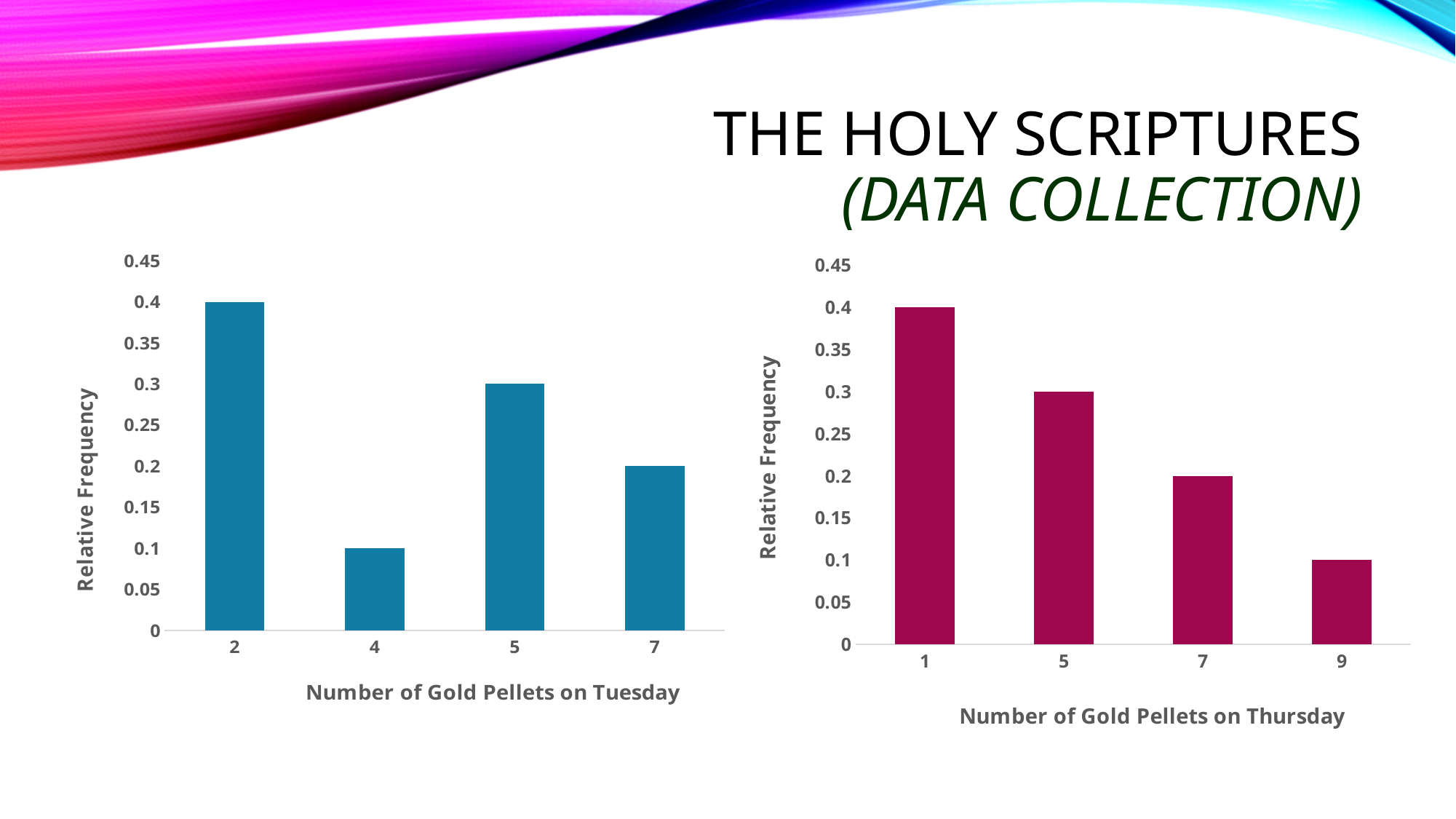
How many categories are shown on the x axis of the chart for Number of Gold Pellets on Thursday (right)? 4 In the chart for Number of Gold Pellets on Tuesday (left), is the relative frequency for 5 gold pellets greater or less than 0.25? greater In the chart for Number of Gold Pellets on Thursday (right), what is the relative frequency for 9 gold pellets? 0.1 In the chart for Number of Gold Pellets on Tuesday (left), which number of gold pellets has the highest relative frequency? 2 In the chart for Number of Gold Pellets on Thursday (right), what is the relative frequency for 5 gold pellets? 0.3 In the chart for Number of Gold Pellets on Thursday (right), do the relative frequencies rise or fall as the number of gold pellets increases along the x axis? fall In the chart for Number of Gold Pellets on Tuesday (left), what is the difference between the relative frequency for 5 gold pellets and for 7 gold pellets? 0.1 In the chart for Number of Gold Pellets on Tuesday (left), what is the relative frequency for 4 gold pellets? 0.1 In the chart for Number of Gold Pellets on Thursday (right), which number of gold pellets has the lowest relative frequency? 9 In the chart for Number of Gold Pellets on Tuesday (left), what is the relative frequency for 2 gold pellets? 0.4 In the chart for Number of Gold Pellets on Thursday (right), which has a larger relative frequency: 1 gold pellet or 7 gold pellets? 1 What kind of chart is the chart for Number of Gold Pellets on Tuesday (left)? bar chart